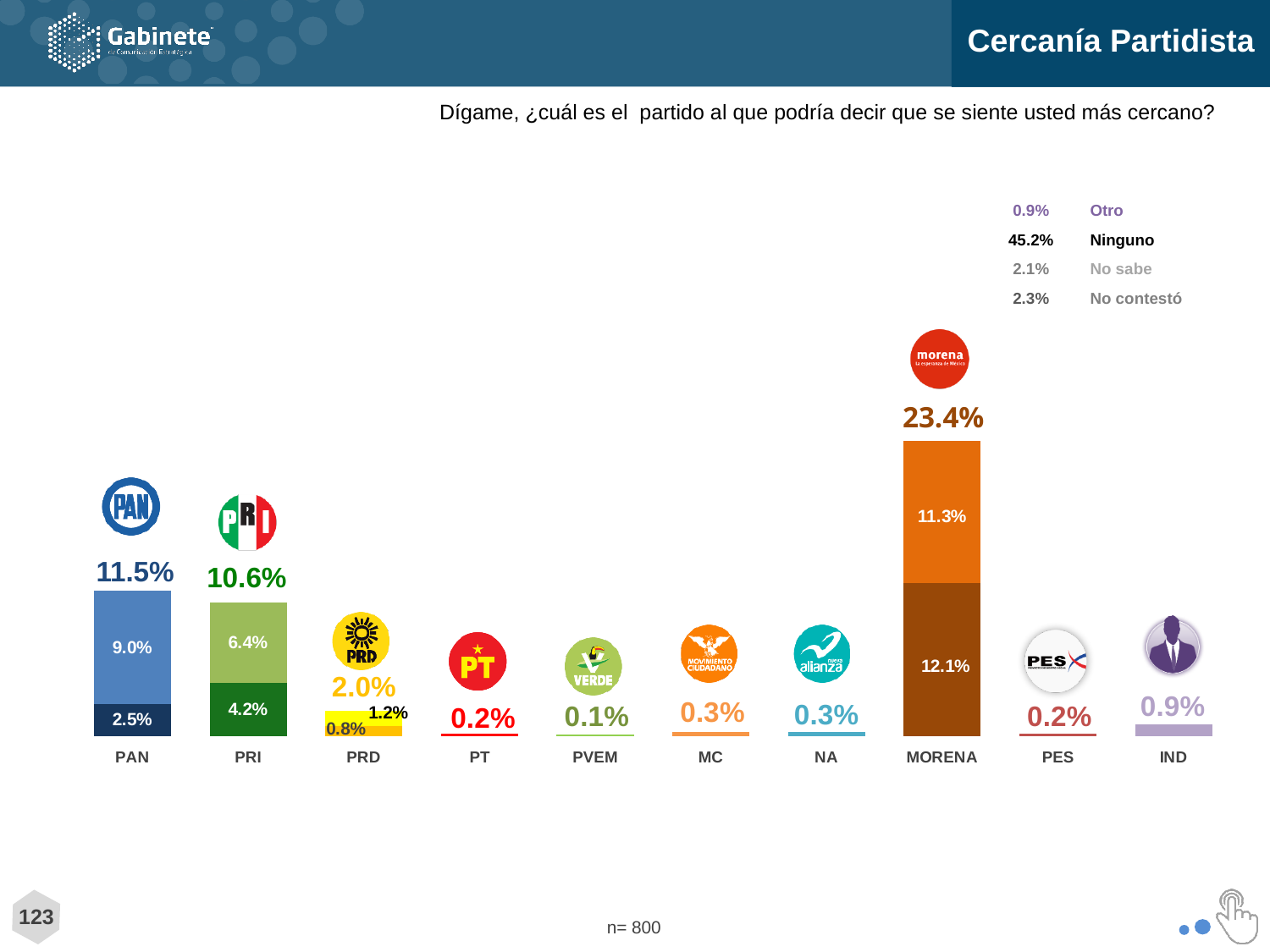
Which is larger, the total for PAN or the total for PRI? PAN What is the value of the upper segment of the MORENA bar? 11.3% How many parties are shown along the x axis of the chart? 10 What is the total value shown for PAN? 11.5% What is the value of the lower (bottom) segment of the PRI bar? 4.2% What is the value shown for IND? 0.9% What percentage is listed for 'Ninguno' in the text at the top right of the chart? 45.2% Which party has the lowest value in the chart? PVEM Which party has the highest total value in the chart? MORENA What is the difference between the total for MORENA and the total for PAN? 11.9% What type of chart is shown on the slide? Bar chart What is the total value shown for MORENA? 23.4%